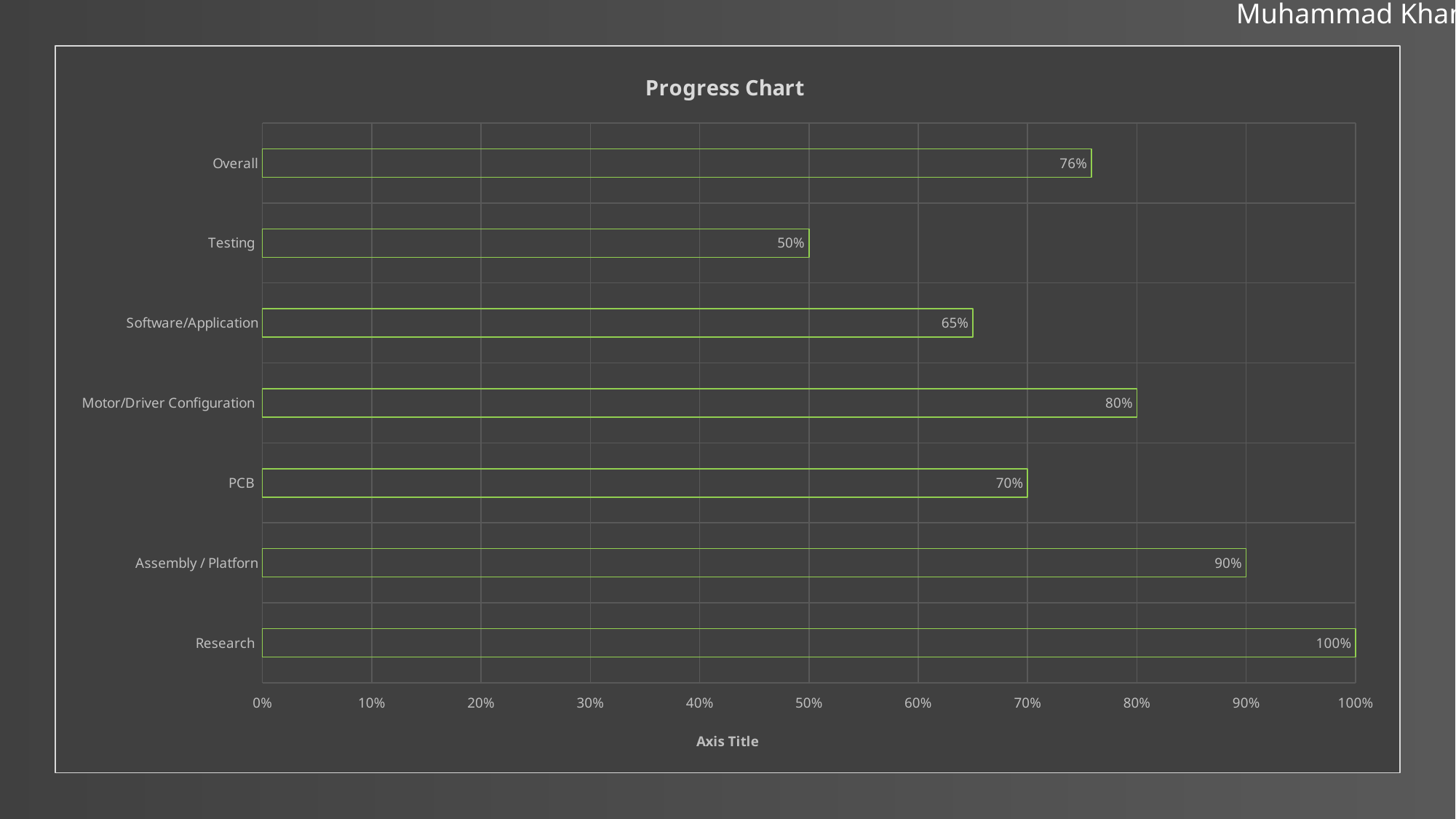
Is the value for Software/Application greater or less than 60%? greater What kind of chart is this? bar chart What is the title of the chart? Progress Chart What is the value for Overall? 76% How many categories are shown in the chart? 7 Which category has the lowest value? Testing What is the value for PCB? 70% What is the value for Testing? 50% Which is larger, the value for PCB or the value for Overall? Overall What is the value for Motor/Driver Configuration? 80% What is the difference between the values for Assembly / Platforn and Software/Application? 25% Which category has the highest value? Research